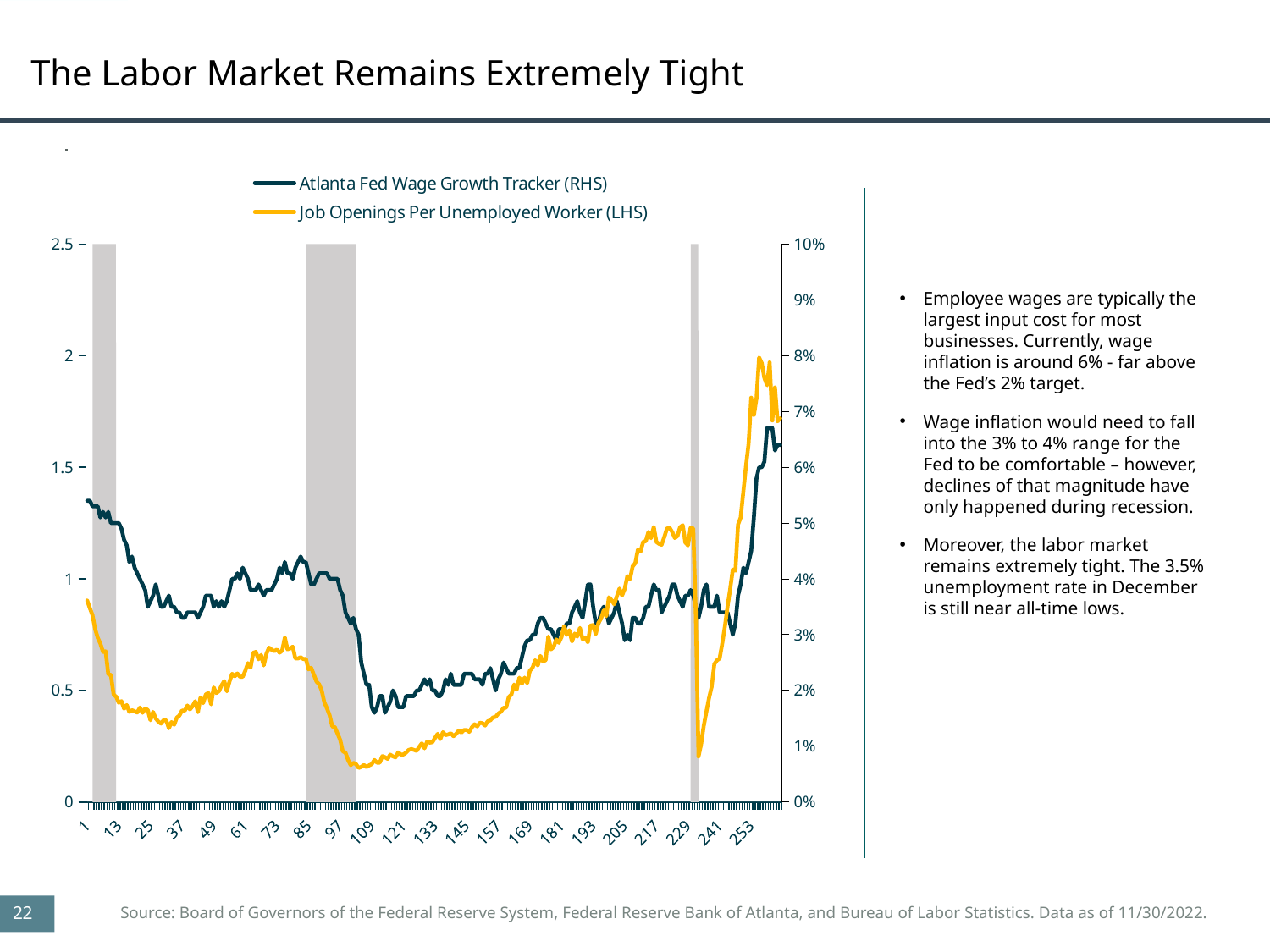
What is the highest value shown on the right-hand axis? 10% Does the Job Openings Per Unemployed Worker series rise or fall between x = 229 and x = 253? rise Is the value of the Atlanta Fed Wage Growth Tracker at x = 109 greater or less than 3%? less How many tick labels are printed along the x axis? 22 Is the value of the Atlanta Fed Wage Growth Tracker at the right end of the chart greater or less than 5%? greater How many series does the chart's legend list? 2 Which series is plotted in yellow? Job Openings Per Unemployed Worker (LHS) What kind of chart is shown on the slide? line chart Does the Atlanta Fed Wage Growth Tracker rise or fall between x = 85 and x = 109? fall Is the value of Job Openings Per Unemployed Worker at x = 109 greater or less than 0.5? less Which series is higher at x = 253 relative to its own axis: Job Openings Per Unemployed Worker (left axis, max 2.5) or the Atlanta Fed Wage Growth Tracker (right axis, max 10%)? Job Openings Per Unemployed Worker